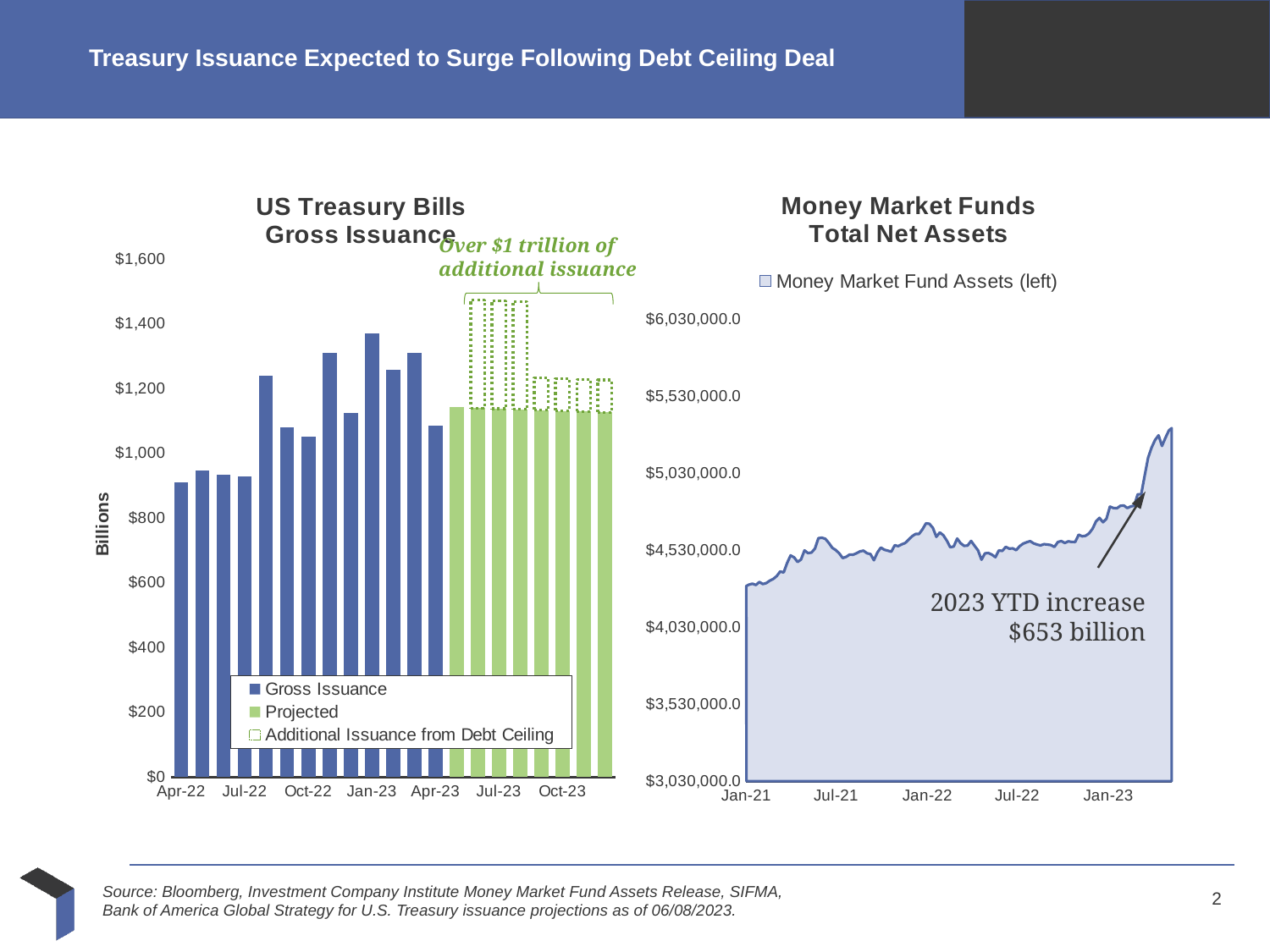
According to the annotation on the 'Money Market Funds Total Net Assets' chart, what is the 2023 YTD increase? $653 billion In the 'US Treasury Bills Gross Issuance' chart, is the Gross Issuance value for Apr-22 greater or less than $1,000? less In the 'US Treasury Bills Gross Issuance' chart, is the Gross Issuance value for Jan-23 greater or less than $1,200? greater In the 'Money Market Funds Total Net Assets' chart, do the values overall rise or fall from Jan-21 to the end of the series? rise What kind of chart is the 'US Treasury Bills Gross Issuance' chart? bar chart How many series does the legend of the 'US Treasury Bills Gross Issuance' chart list? 3 In the 'Money Market Funds Total Net Assets' chart, is the value at Jan-21 greater or less than $4,530,000.0? less In the 'US Treasury Bills Gross Issuance' chart, which is larger: the Gross Issuance for Jan-23 or for Apr-23? Jan-23 In the 'US Treasury Bills Gross Issuance' chart, which labeled month has the highest Gross Issuance bar? Jan-23 What is the legend entry for the dotted-outline series in the 'US Treasury Bills Gross Issuance' chart? Additional Issuance from Debt Ceiling How many series does the legend of the 'Money Market Funds Total Net Assets' chart list? 1 What kind of chart is the 'Money Market Funds Total Net Assets' chart? area chart